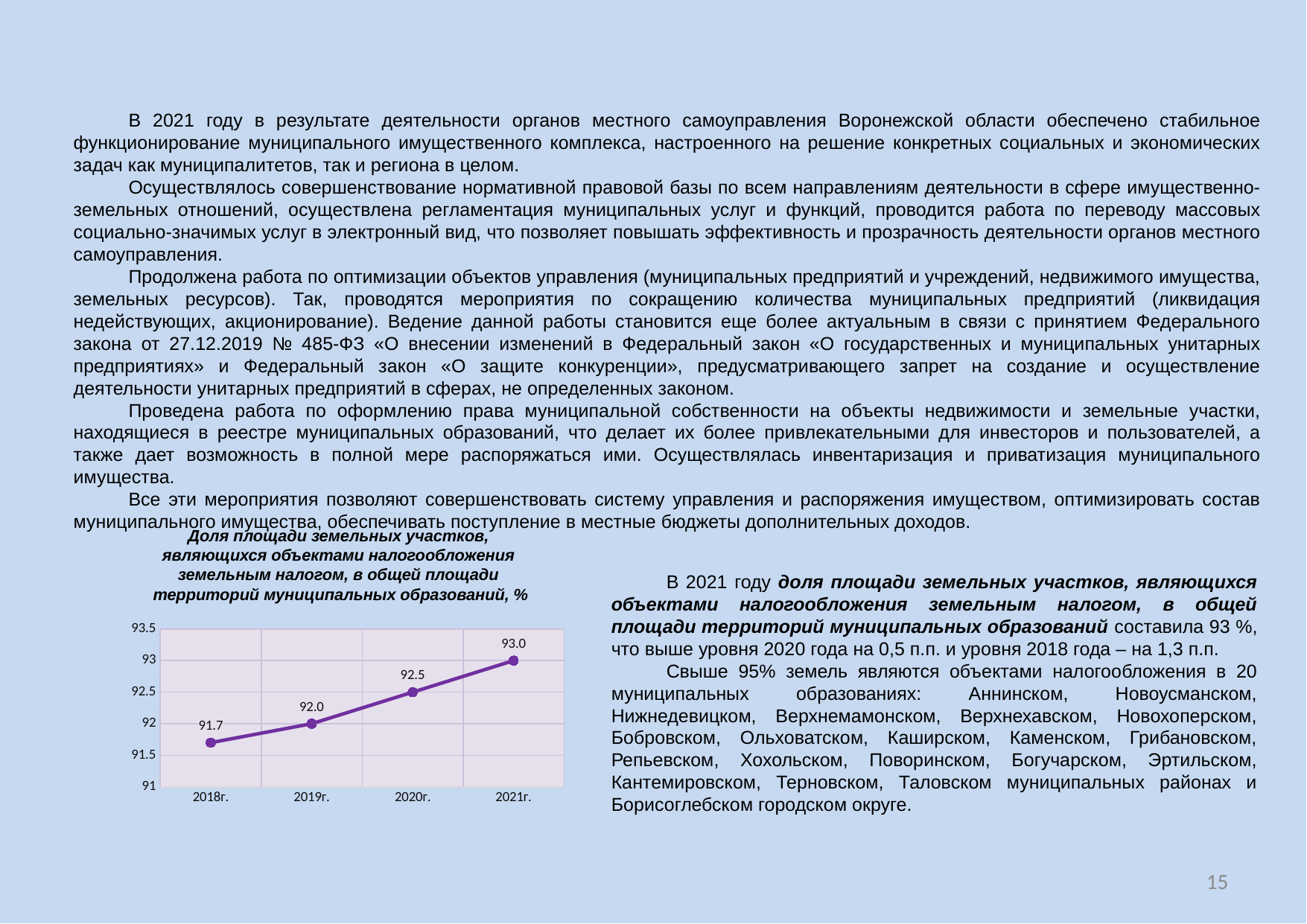
How many years are plotted on the chart? 4 Which year has the highest value on the chart? 2021г. Which year has the lowest value on the chart? 2018г. What is the difference between the values for 2021г. and 2018г.? 1.3 What is the value for 2018г. on the chart? 91.7 Which is larger, the value for 2019г. or the value for 2020г.? 2020г. What is the value for 2019г. on the chart? 92.0 What is the difference between the values for 2020г. and 2019г.? 0.5 Do the values rise or fall from 2018г. to 2021г.? rise What is the value for 2021г. on the chart? 93.0 What kind of chart is shown on the slide? line chart What is the value for 2020г. on the chart? 92.5